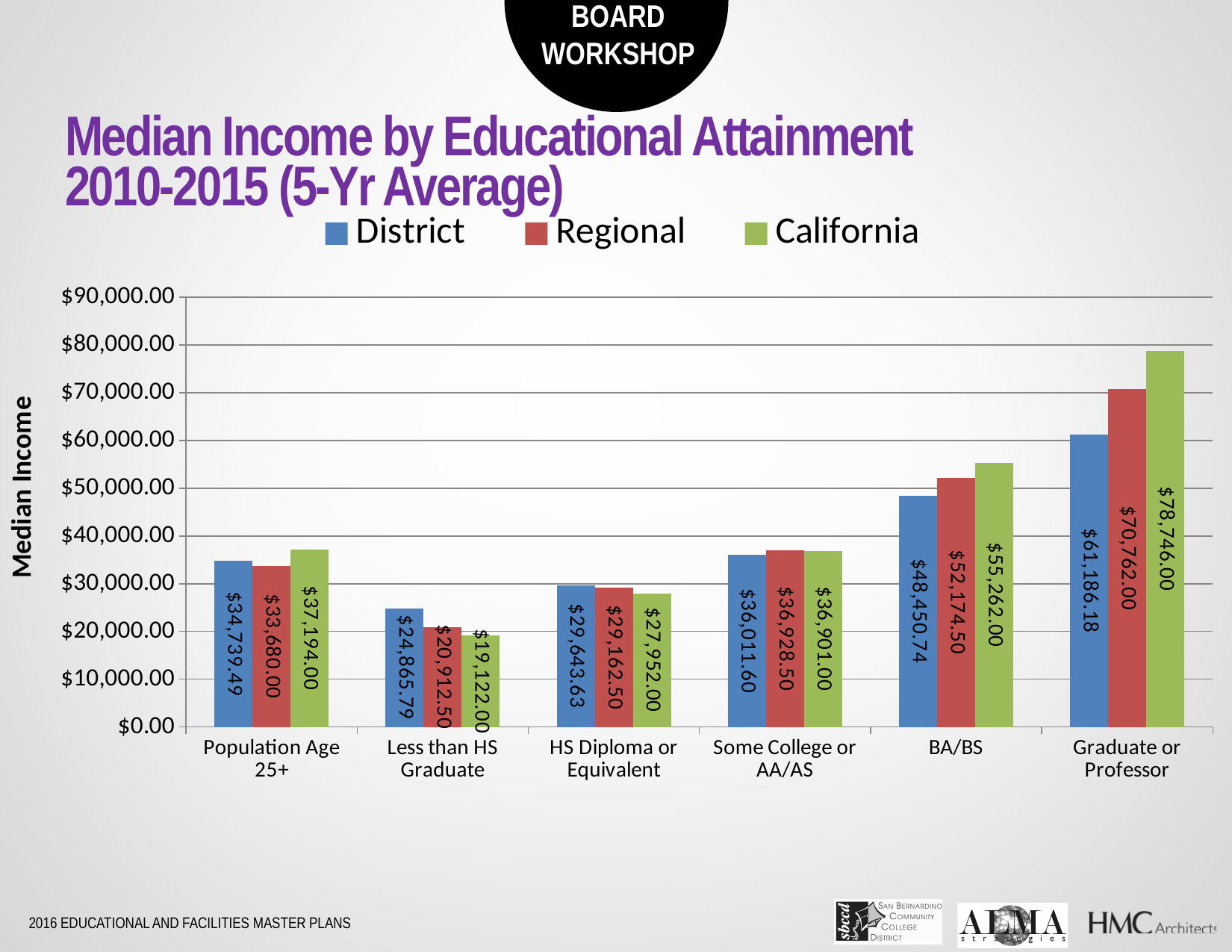
What is the District median income for BA/BS? $48,450.74 What is the California median income for Graduate or Professor? $78,746.00 How many series does the legend list? 3 Which educational attainment category has the lowest District median income? Less than HS Graduate How many educational attainment categories are shown on the x axis? 6 What is the Regional median income for Less than HS Graduate? $20,912.50 What is the difference between the California and Regional median incomes for BA/BS? $3,087.50 Which educational attainment category has the highest California median income? Graduate or Professor For Less than HS Graduate, which is larger: the District or the California median income? District What is the difference between the California and District median incomes for Graduate or Professor? $17,559.82 What is the District median income for Some College or AA/AS? $36,011.60 What kind of chart is shown on the slide? Bar chart